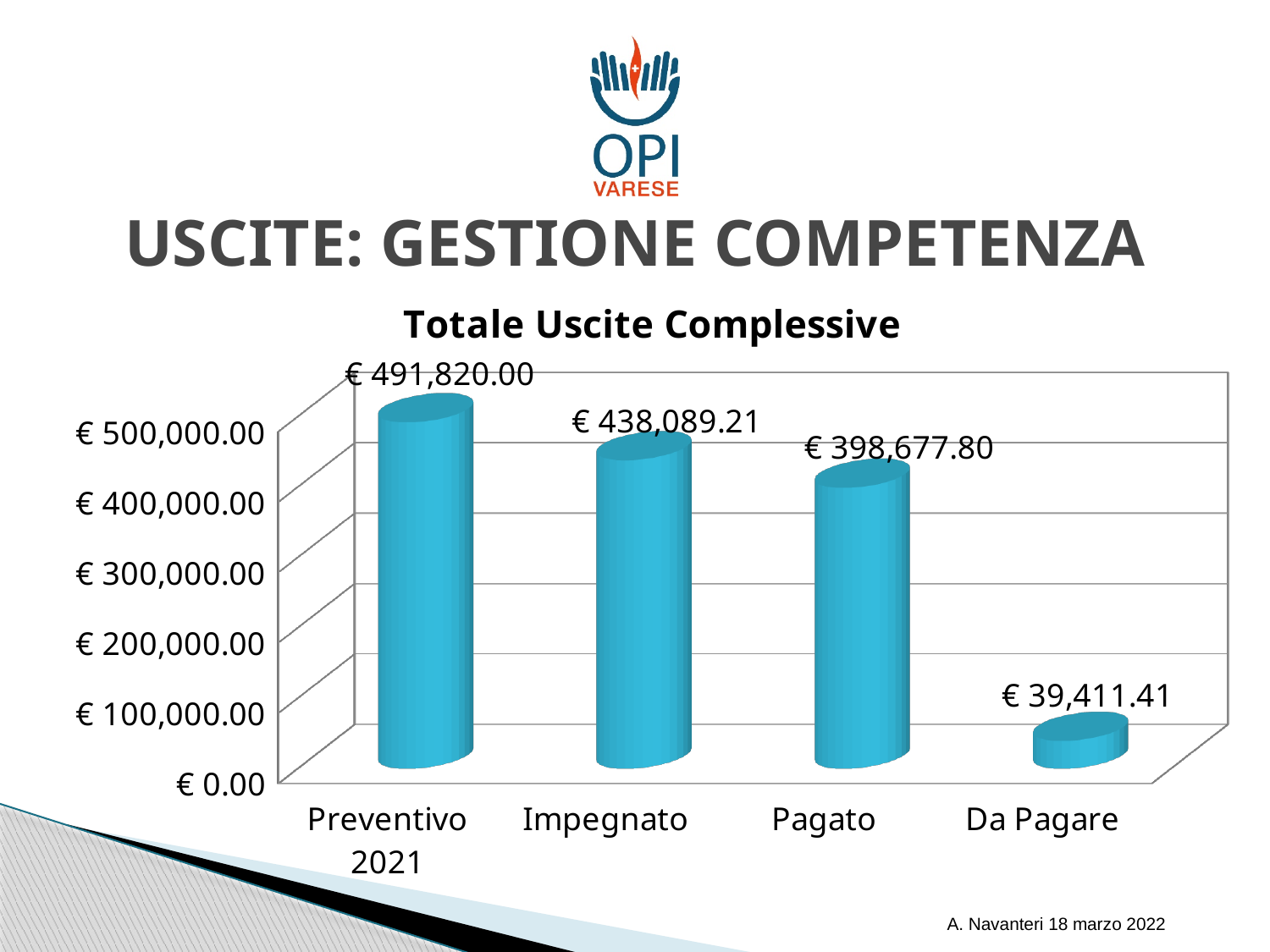
What is the value for Preventivo 2021? € 491,820.00 What kind of chart is shown on the slide? Bar chart Which is larger, Pagato or Da Pagare? Pagato How many categories are shown in the chart? 4 Which category has the highest value? Preventivo 2021 What is the difference between Impegnato and Pagato? € 39,411.41 What is the difference between Preventivo 2021 and Impegnato? € 53,730.79 Which category has the lowest value? Da Pagare What is the title of the chart? Totale Uscite Complessive What is the value for Da Pagare? € 39,411.41 What is the value for Impegnato? € 438,089.21 What is the value for Pagato? € 398,677.80